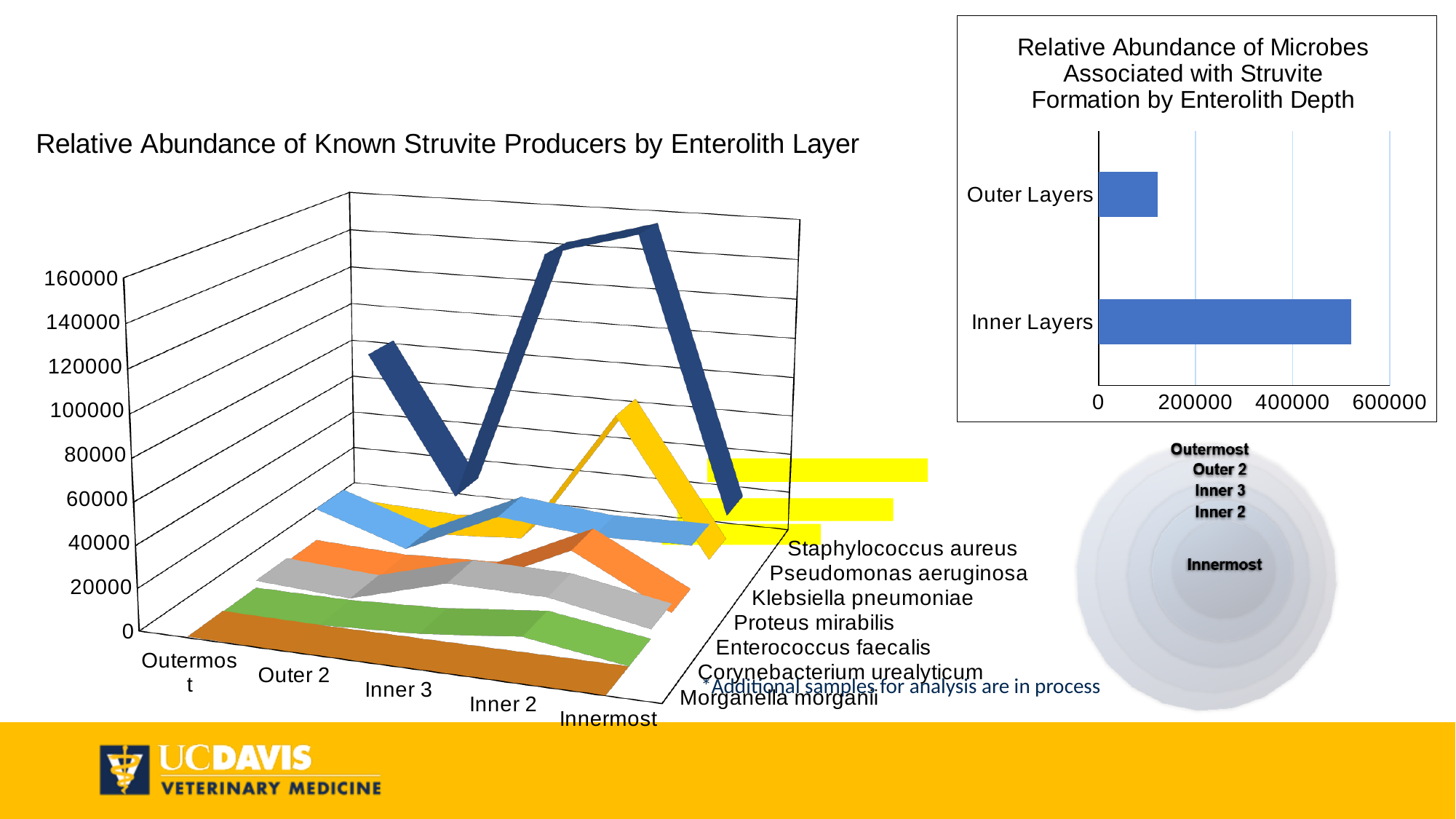
In the chart titled 'Relative Abundance of Known Struvite Producers by Enterolith Layer', how many microbial species (series) are plotted? 7 In the chart titled 'Relative Abundance of Microbes Associated with Struvite Formation by Enterolith Depth', is the value for Outer Layers greater or less than 200000? less In the chart titled 'Relative Abundance of Microbes Associated with Struvite Formation by Enterolith Depth', is the value for Inner Layers greater or less than 600000? less In the chart titled 'Relative Abundance of Known Struvite Producers by Enterolith Layer', which species reaches the highest value? Staphylococcus aureus In the chart titled 'Relative Abundance of Microbes Associated with Struvite Formation by Enterolith Depth', is the value for Inner Layers greater or less than 400000? greater In the chart titled 'Relative Abundance of Microbes Associated with Struvite Formation by Enterolith Depth', which category has the highest value? Inner Layers In the chart titled 'Relative Abundance of Known Struvite Producers by Enterolith Layer', how many enterolith layers are shown along the x axis? 5 In the chart titled 'Relative Abundance of Microbes Associated with Struvite Formation by Enterolith Depth', how many categories are shown? 2 In the chart titled 'Relative Abundance of Microbes Associated with Struvite Formation by Enterolith Depth', which is larger: Outer Layers or Inner Layers? Inner Layers In the chart titled 'Relative Abundance of Microbes Associated with Struvite Formation by Enterolith Depth', which category has the lowest value? Outer Layers What type of chart is the chart titled 'Relative Abundance of Microbes Associated with Struvite Formation by Enterolith Depth'? bar chart In the chart titled 'Relative Abundance of Known Struvite Producers by Enterolith Layer', what is the highest value labelled on the vertical axis? 160000